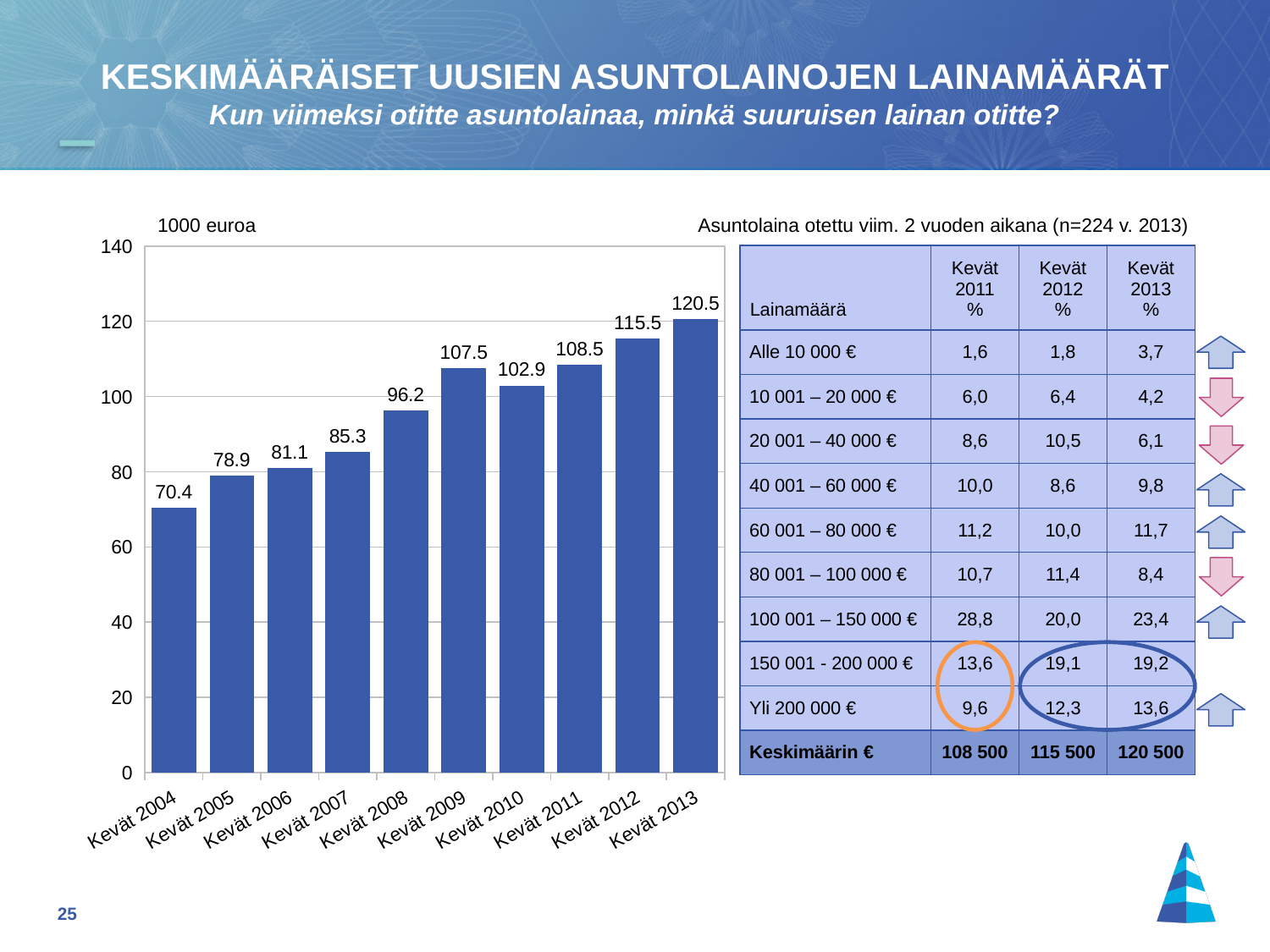
Which category has the highest value? Kevät 2013 What unit label is shown above the y axis of the chart? 1000 euroa Do the values rise or fall from Kevät 2004 to Kevät 2009? rise What is the difference between the values for Kevät 2013 and Kevät 2004? 50.1 What is the value for Kevät 2013? 120.5 Is the value for Kevät 2008 greater or less than 100? less What kind of chart is shown on the slide? bar chart What is the value for Kevät 2004? 70.4 Which category has the lowest value? Kevät 2004 How many categories are shown on the x axis? 10 Which is larger, the value for Kevät 2009 or the value for Kevät 2010? Kevät 2009 What is the value for Kevät 2010? 102.9